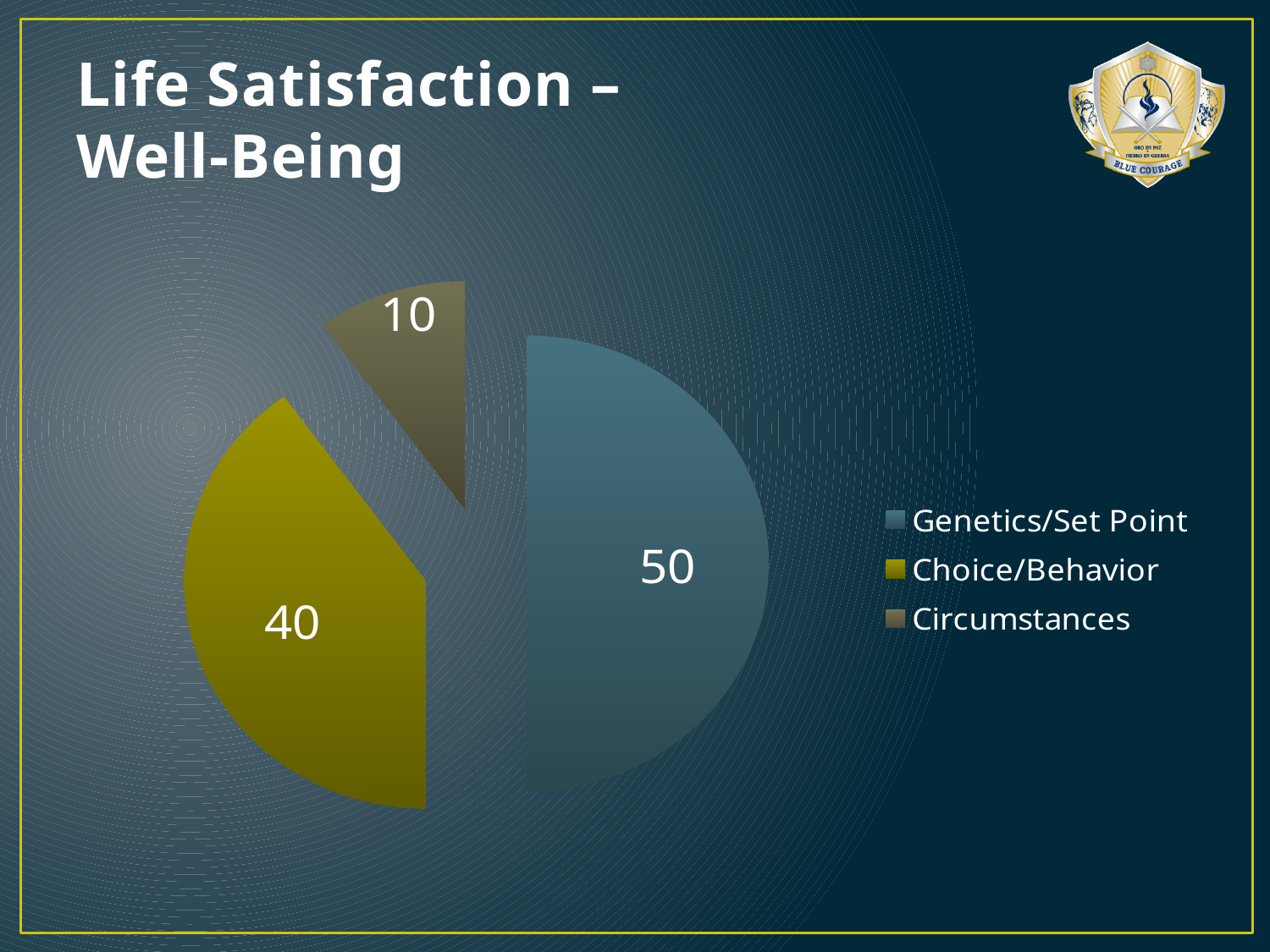
Which legend entry is shown in blue? Genetics/Set Point What value is shown for Choice/Behavior? 40 What kind of chart is shown on the slide? Pie chart What value is shown for Genetics/Set Point? 50 Which category has the smallest slice of the pie? Circumstances What is the difference between the values for Choice/Behavior and Circumstances? 30 Which is larger, the value for Choice/Behavior or the value for Circumstances? Choice/Behavior Which category has the largest slice of the pie? Genetics/Set Point What value is shown for Circumstances? 10 What share of the pie does the Circumstances slice represent? 10% What is the difference between the values for Genetics/Set Point and Choice/Behavior? 10 How many categories does the pie chart show? 3